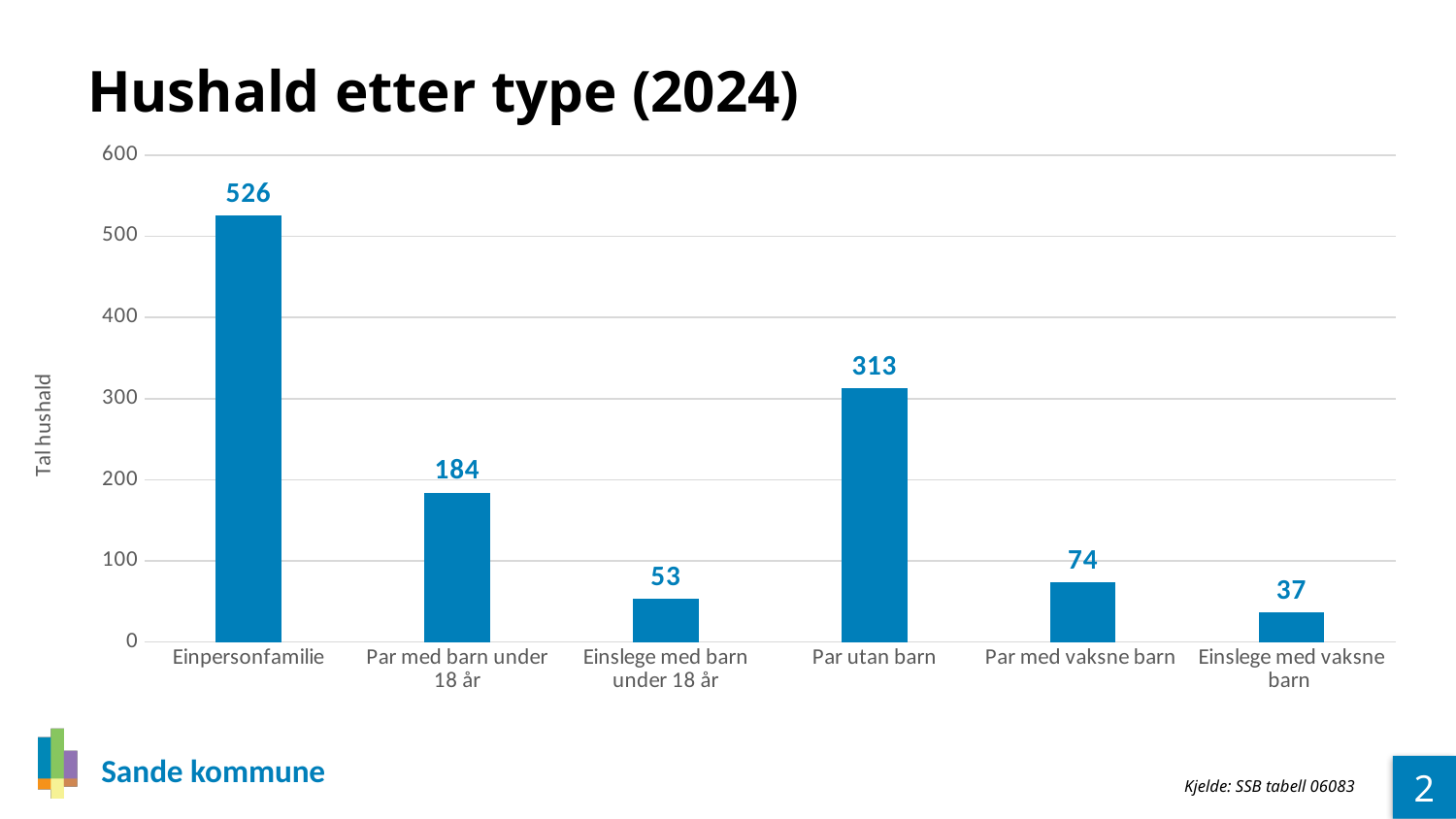
Which is larger, Par med vaksne barn or Einslege med barn under 18 år? Par med vaksne barn What kind of chart is this? bar chart What is the difference between Einpersonfamilie and Par utan barn? 213 Which category has the highest value? Einpersonfamilie What is the value for Einslege med vaksne barn? 37 Which category has the lowest value? Einslege med vaksne barn Is the value for Par med barn under 18 år greater or less than 200? less What is the value for Einpersonfamilie? 526 What is the difference between Par med barn under 18 år and Einslege med barn under 18 år? 131 What is the value for Par utan barn? 313 What is the title of the chart? Hushald etter type (2024) How many categories are shown on the x axis? 6